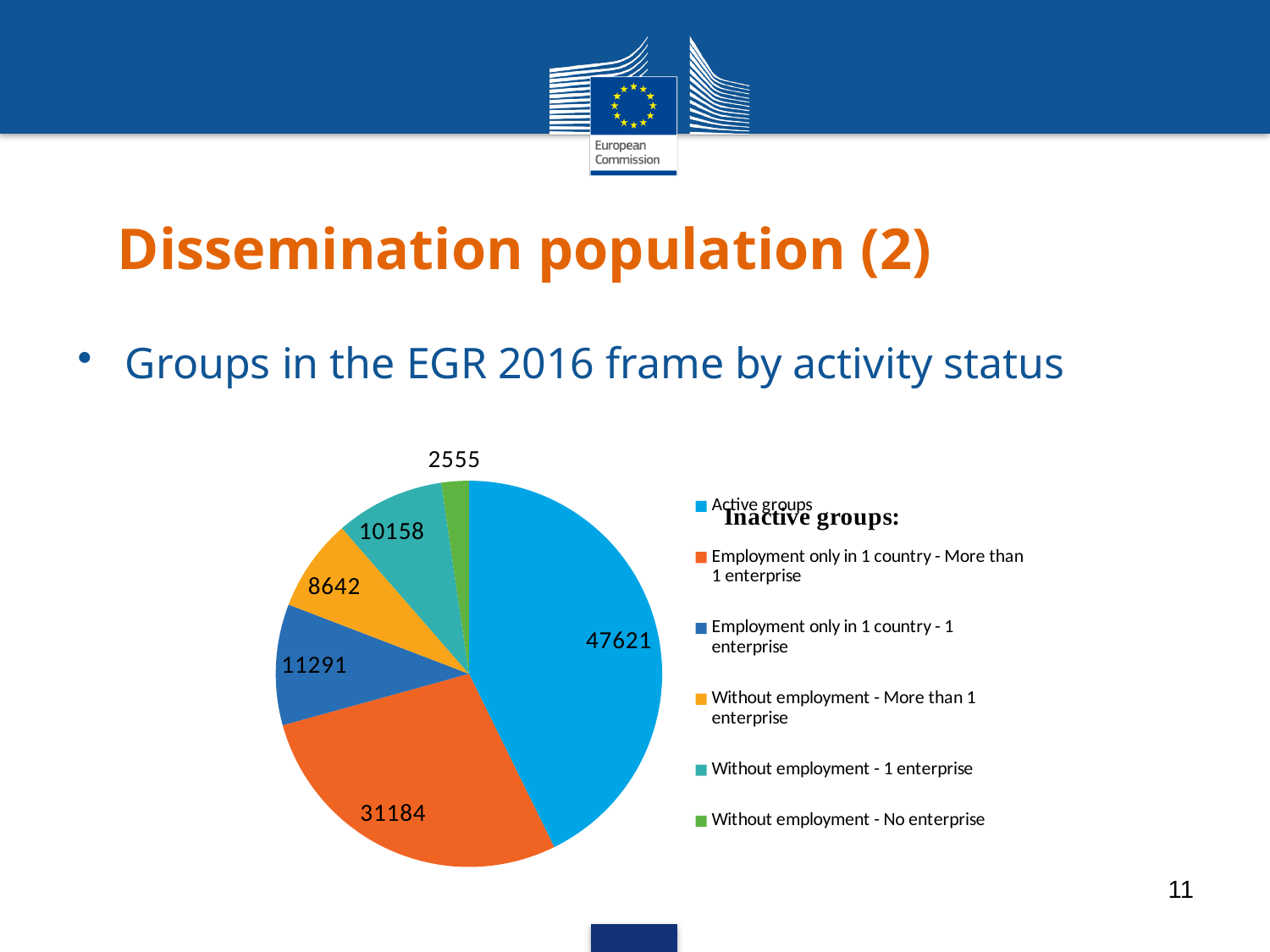
What is the difference between the value for Active groups and the value for 'Employment only in 1 country - More than 1 enterprise'? 16437 What value is shown for Active groups in the pie chart? 47621 What type of chart is shown on the slide? Pie chart What value is shown for 'Without employment - No enterprise'? 2555 What is the total of all the values shown in the pie chart? 111451 How many entries does the legend of the pie chart list? 6 Which category has the largest slice of the pie chart? Active groups What value is shown for 'Without employment - 1 enterprise'? 10158 How many slices does the pie chart have? 6 What value is shown for 'Employment only in 1 country - More than 1 enterprise'? 31184 Which is larger: 'Employment only in 1 country - 1 enterprise' or 'Without employment - More than 1 enterprise'? Employment only in 1 country - 1 enterprise Which category has the smallest slice of the pie chart? Without employment - No enterprise